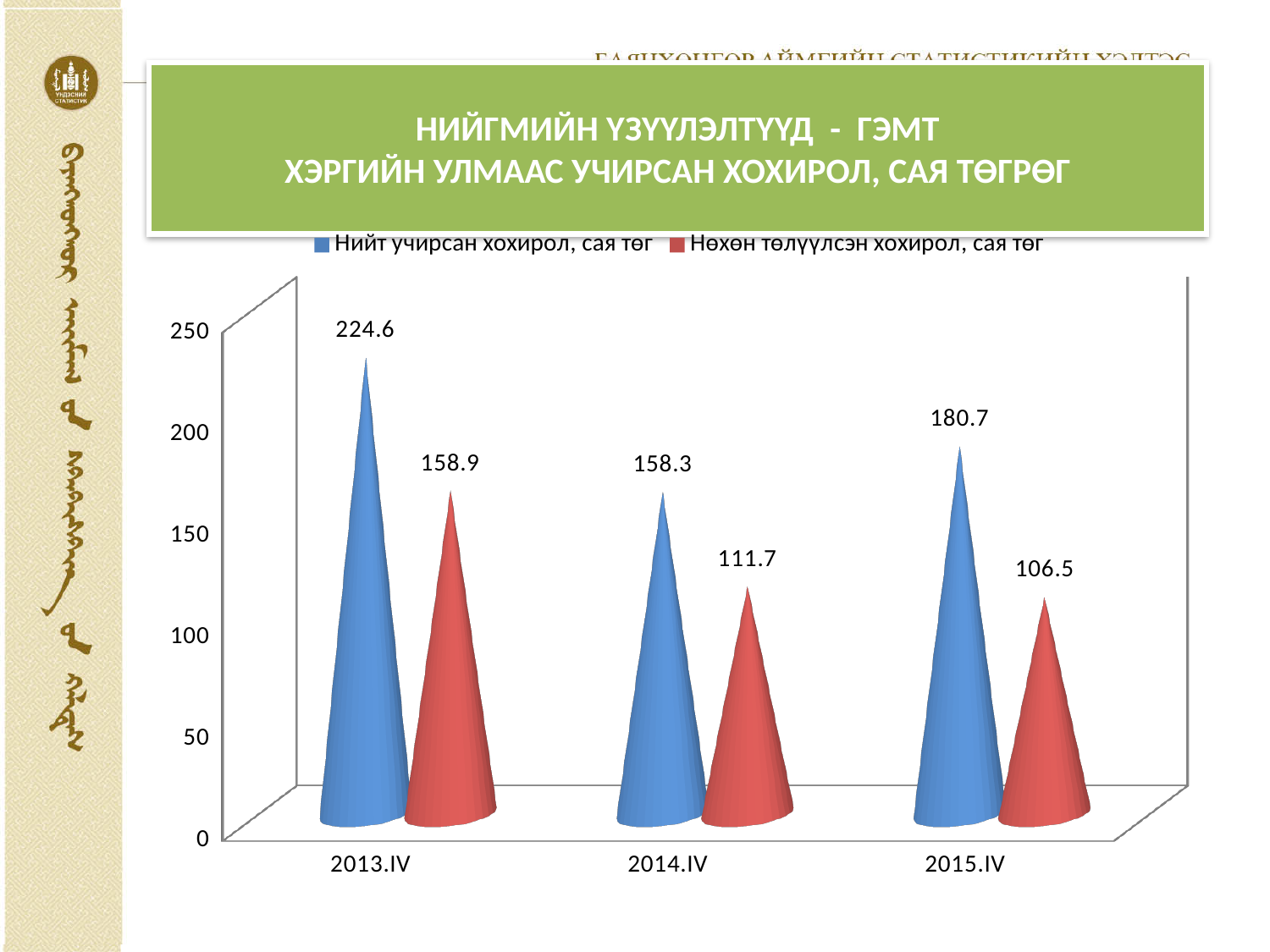
In which period is Нийт учирсан хохирол, сая төг highest? 2013.IV What is the value of Нөхөн төлүүлсэн хохирол, сая төг for 2014.IV? 111.7 Which colour represents Нөхөн төлүүлсэн хохирол, сая төг in the chart? red What is the difference between Нийт учирсан хохирол and Нөхөн төлүүлсэн хохирол in 2015.IV? 74.2 What is the value of Нөхөн төлүүлсэн хохирол, сая төг for 2015.IV? 106.5 What kind of chart is shown on the slide? bar chart How many periods are shown on the x axis? 3 Which is larger: Нийт учирсан хохирол in 2014.IV or Нөхөн төлүүлсэн хохирол in 2013.IV? Нөхөн төлүүлсэн хохирол in 2013.IV Is the value of Нийт учирсан хохирол, сая төг for 2015.IV greater or less than 200? less How many series does the legend list? 2 In which period is Нөхөн төлүүлсэн хохирол, сая төг lowest? 2015.IV What is the value of Нийт учирсан хохирол, сая төг for 2013.IV? 224.6